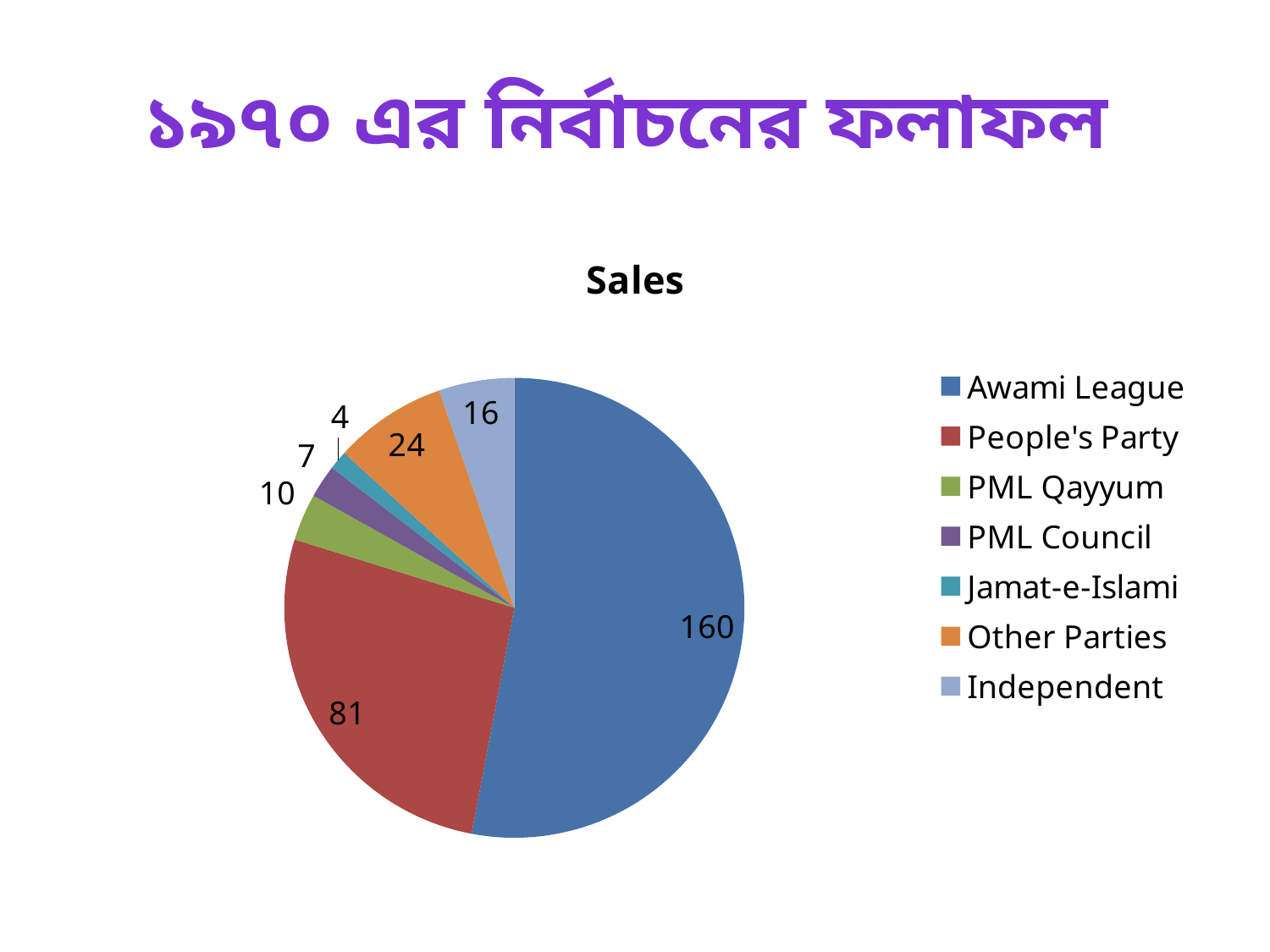
Which category has the largest slice of the pie? Awami League What type of chart is shown on the slide? pie chart What is the value for Jamat-e-Islami? 4 What is the value for Other Parties? 24 Which category has the smallest slice of the pie? Jamat-e-Islami What is the difference between the values for Awami League and People's Party? 79 What is the value for People's Party? 81 What is the title of the chart? Sales Which is larger, the value for PML Qayyum or the value for PML Council? PML Qayyum What is the value for Independent? 16 How many categories does the pie chart have? 7 What is the value for Awami League? 160